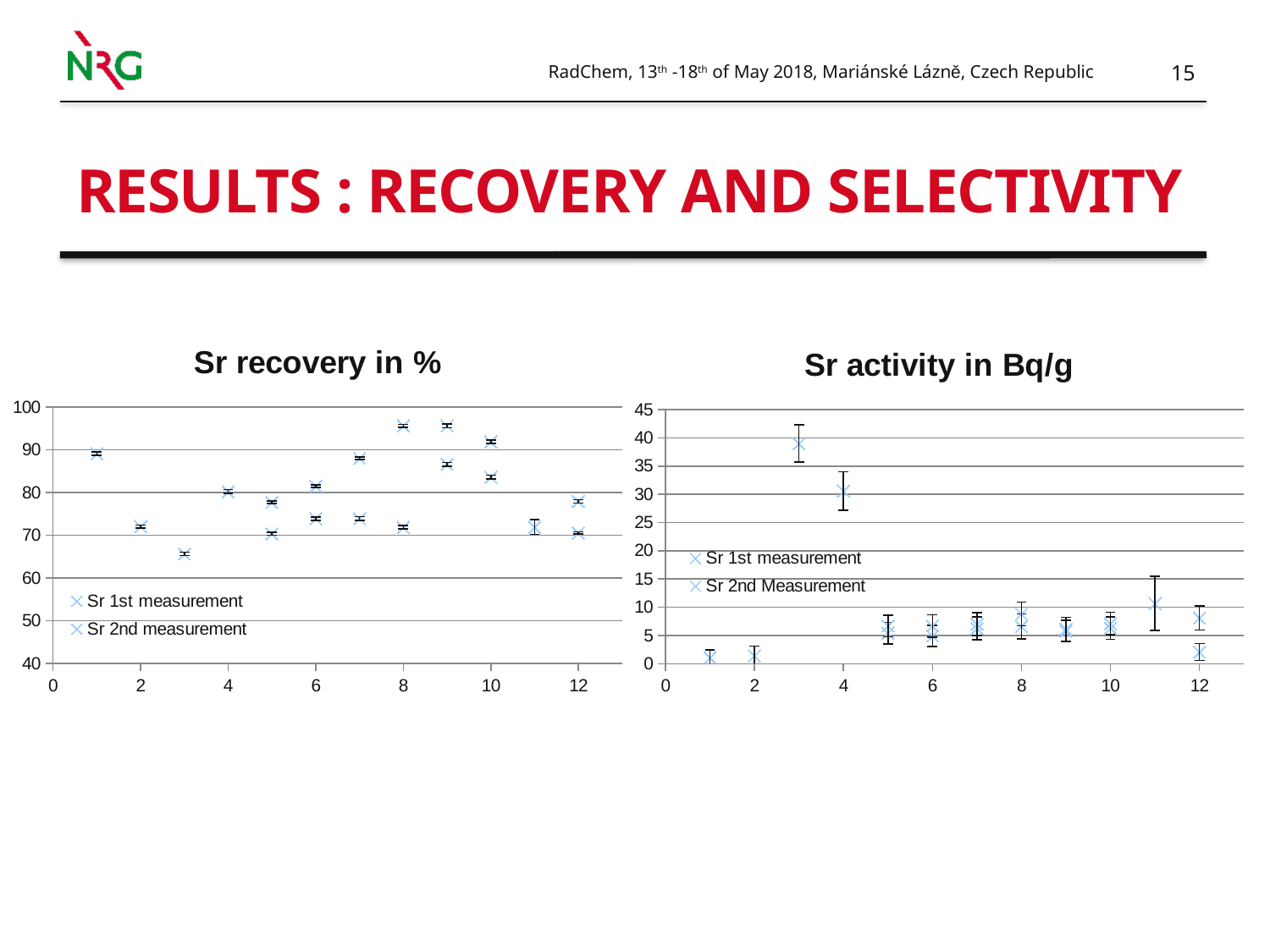
In the 'Sr activity in Bq/g' chart, which has the larger value: the point at x = 3 or the point at x = 4? x = 3 In the 'Sr recovery in %' chart, how many x positions (samples) have points plotted? 12 What kind of chart is the 'Sr recovery in %' chart? scatter chart In the 'Sr recovery in %' chart, is the value at x = 3 greater or less than 70? less How many series does the legend of the 'Sr activity in Bq/g' chart list? 2 What are the two legend entries of the 'Sr activity in Bq/g' chart? Sr 1st measurement and Sr 2nd Measurement In the 'Sr activity in Bq/g' chart, is the value at x = 3 greater or less than 35? greater In the 'Sr recovery in %' chart, is the higher of the two values at x = 8 greater or less than 90? greater How many series does the legend of the 'Sr recovery in %' chart list? 2 In the 'Sr activity in Bq/g' chart, at which x position is the highest activity plotted? 3